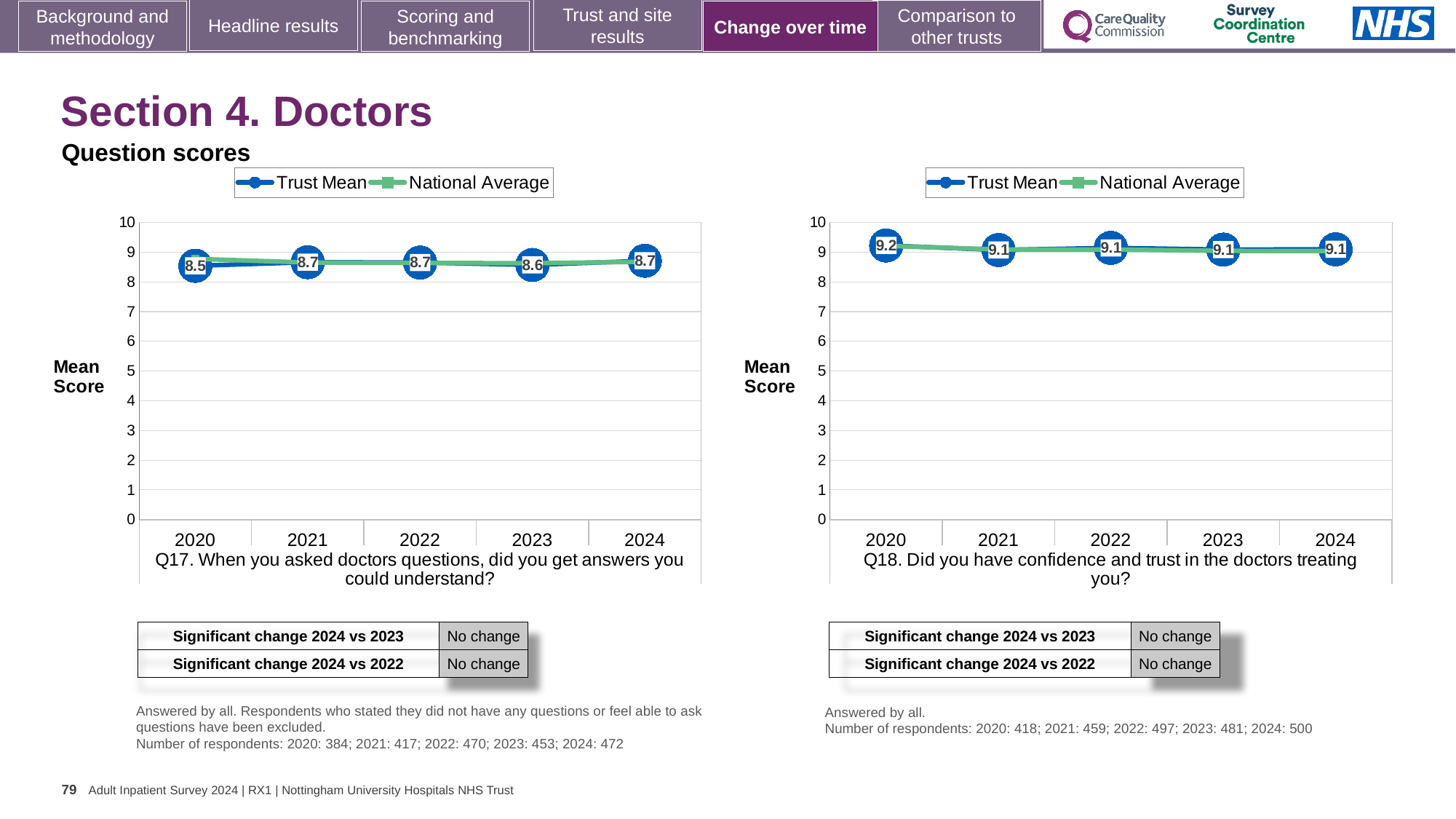
In the Q18 chart on the right, is the National Average for 2022 greater or less than 8? greater In the Q18 chart on the right, what is the Trust Mean score for 2023? 9.1 In the Q17 chart on the left, is the Trust Mean score higher in 2021 or in 2023? 2021 How many series does the legend of the Q18 chart on the right list? 2 What type of chart is used for Q17 on the left? Line chart In the Q17 chart on the left, what is the difference between the Trust Mean scores for 2024 and 2020? 0.2 How many years are plotted on the x axis of the Q17 chart on the left? 5 In the Q18 chart on the right, which year has the highest Trust Mean score? 2020 In the Q17 chart on the left, which year has the lowest Trust Mean score? 2020 In the Q17 chart on the left, what is the Trust Mean score for 2024? 8.7 In the Q17 chart on the left, what is the Trust Mean score for 2020? 8.5 In the Q18 chart on the right, what is the Trust Mean score for 2020? 9.2